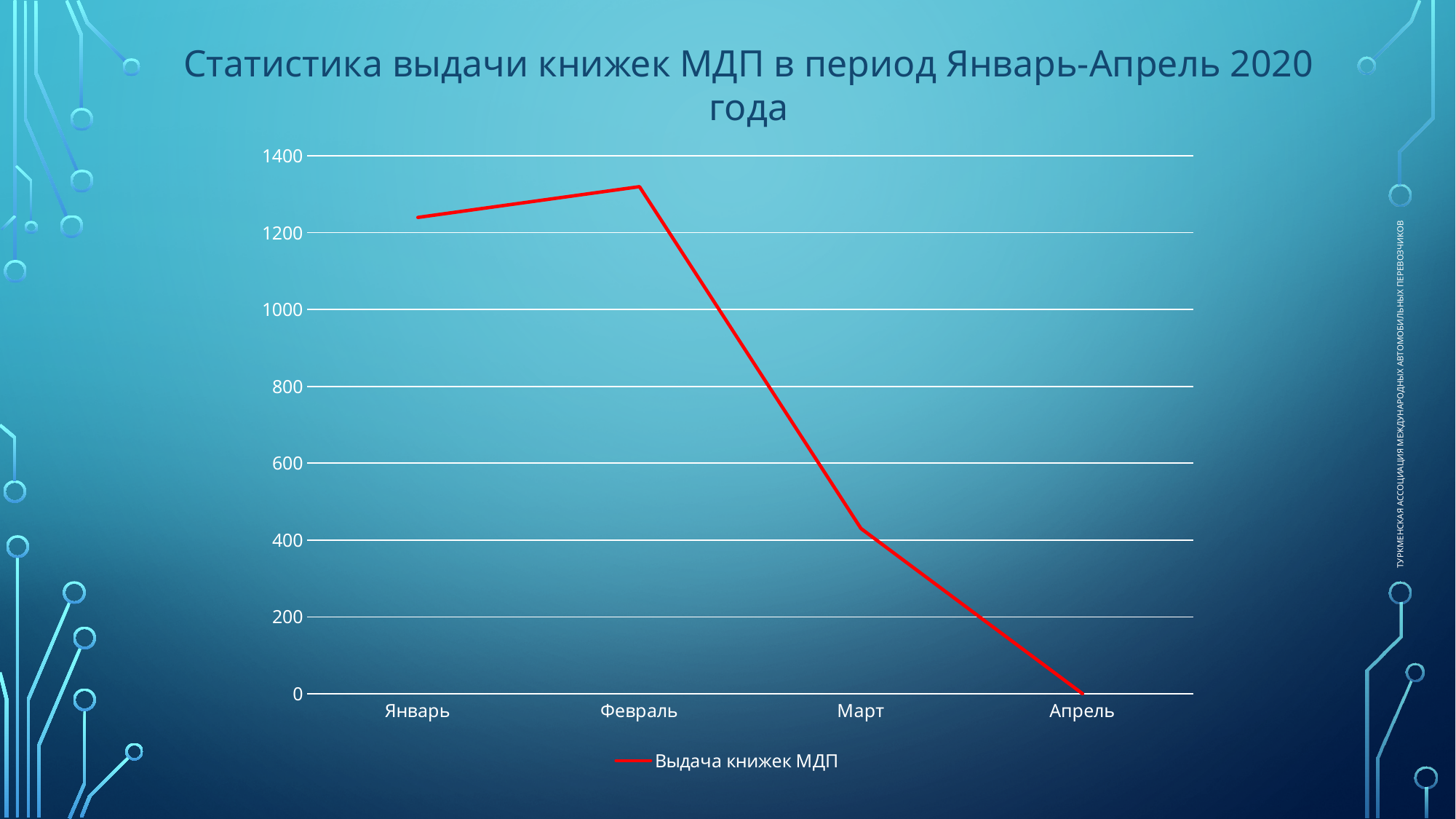
Which is larger, the value for Январь or the value for Март? Январь Which month has the highest value for Выдача книжек МДП? Февраль Which month has the lowest value for Выдача книжек МДП? Апрель What is the name of the series shown in the legend? Выдача книжек МДП Is the value for Январь greater or less than 1200? greater Is the value for Март greater or less than 600? less How many months are plotted along the x axis? 4 Is the value for Апрель greater or less than 200? less What kind of chart is shown on the slide? line chart How do the values change from Февраль to Апрель? they fall How many series does the legend list? 1